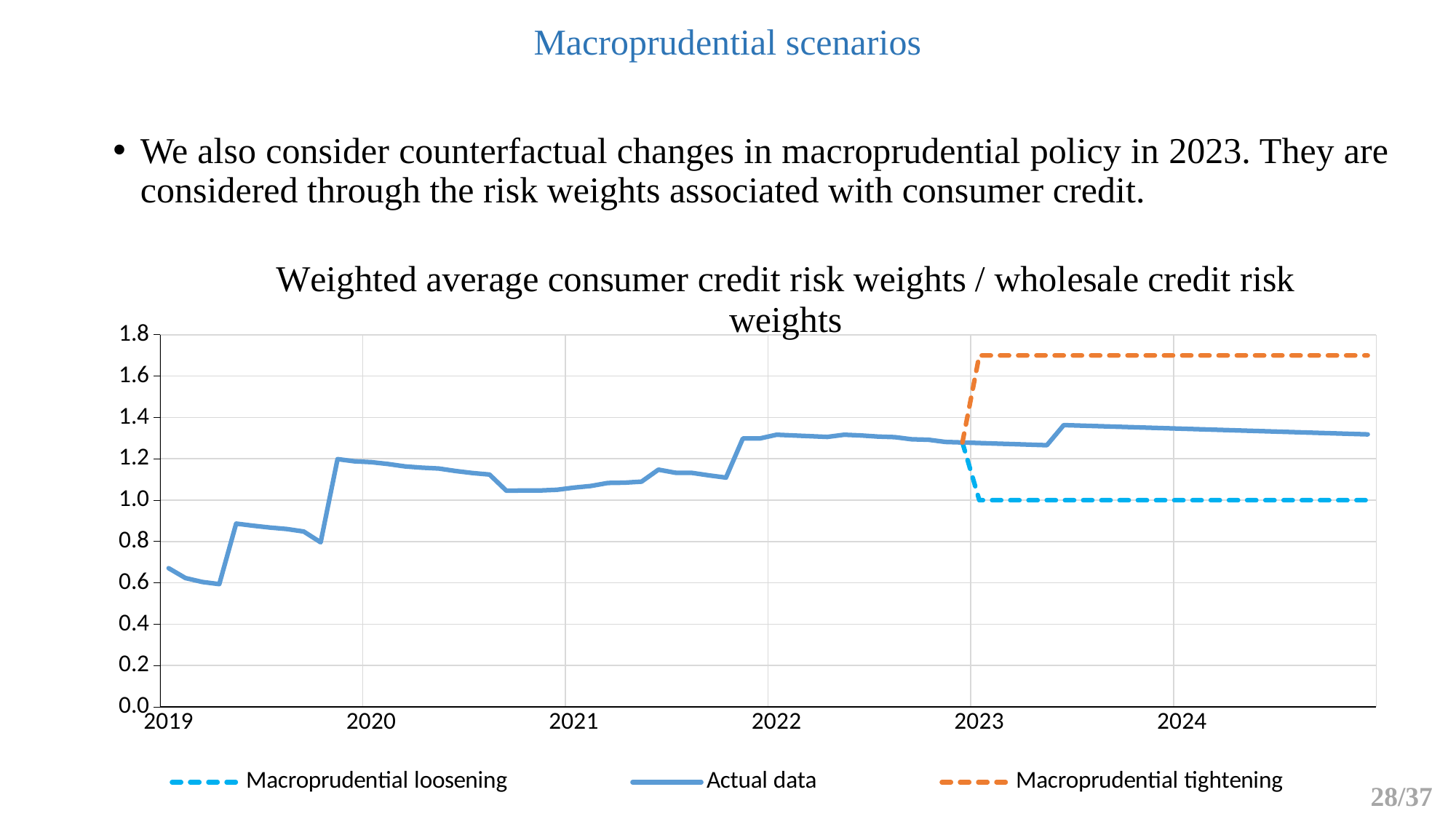
Does the Actual data series generally rise or fall between 2019 and 2022? rise Which series is drawn as a solid line? Actual data Is the value of the Actual data series at the start of 2019 greater or less than 0.8? less What value does the Macroprudential loosening series settle at after 2023? 1.0 What is the title of the chart? Weighted average consumer credit risk weights / wholesale credit risk weights Which series has the lowest values in 2024? Macroprudential loosening Which series has the highest values in 2024? Macroprudential tightening In 2024, is the Actual data series higher or lower than the Macroprudential loosening series? higher How many series does the legend list? 3 Is the value of the Actual data series at the start of 2022 greater or less than 1.2? greater Is the value of the Macroprudential tightening series in 2024 greater or less than 1.6? greater What kind of chart is shown on the slide? line chart